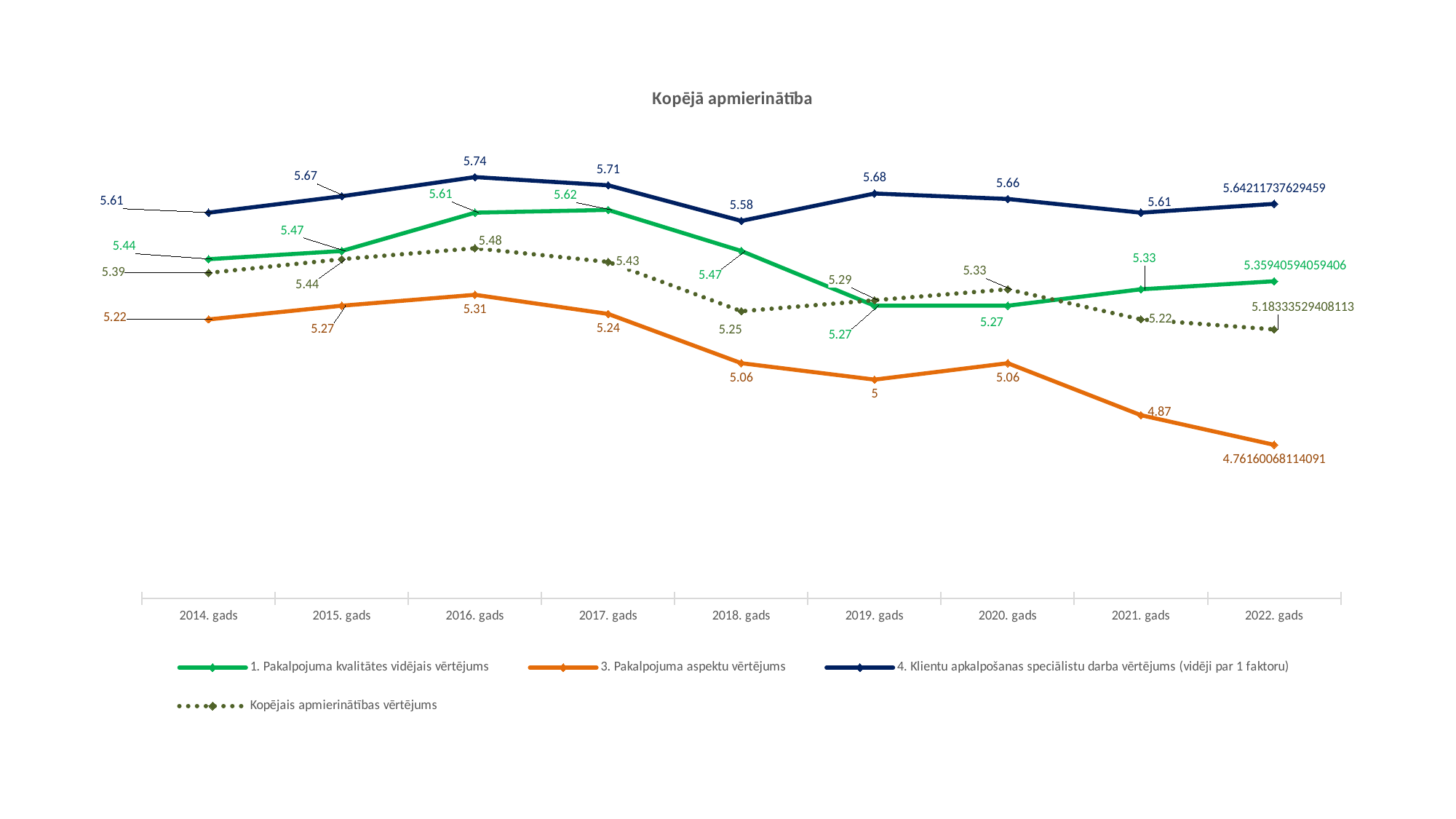
What is the value of 'Kopējais apmierinātības vērtējums' in 2018. gads? 5.25 How many years are shown on the x axis? 9 In which year does '1. Pakalpojuma kvalitātes vidējais vērtējums' reach its highest value? 2017. gads Which series has the higher value in 2020. gads: '1. Pakalpojuma kvalitātes vidējais vērtējums' or 'Kopējais apmierinātības vērtējums'? Kopējais apmierinātības vērtējums What kind of chart is shown on the slide? line chart In which year is '3. Pakalpojuma aspektu vērtējums' at its lowest? 2022. gads Does '3. Pakalpojuma aspektu vērtējums' rise or fall from 2020. gads to 2022. gads? fall What is the difference between '4. Klientu apkalpošanas speciālistu darba vērtējums' and '3. Pakalpojuma aspektu vērtējums' in 2021. gads? 0.74 What is the value of '4. Klientu apkalpošanas speciālistu darba vērtējums' in 2016. gads? 5.74 What is the title of the chart? Kopējā apmierinātība What is the value of '3. Pakalpojuma aspektu vērtējums' in 2019. gads? 5 How many series does the legend list? 4